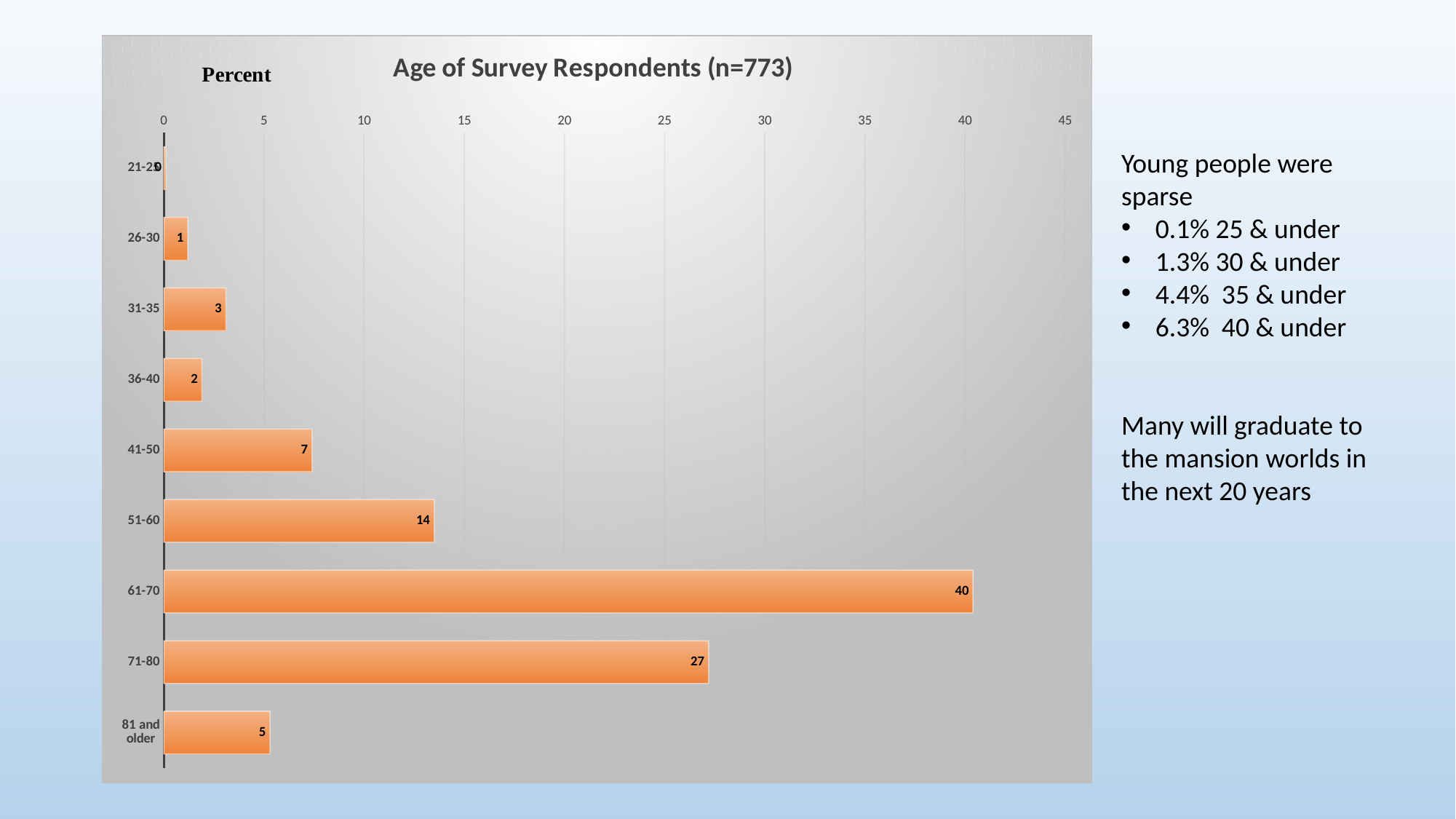
What is the difference between the values for the 61-70 and 71-80 age groups? 13 How many age groups are shown in the chart? 9 Is the value for the 71-80 age group greater or less than 25? greater What is the value for the 81 and older age group? 5 What is the title of the chart? Age of Survey Respondents (n=773) What is the difference between the values for the 51-60 and 41-50 age groups? 7 Which age group has the highest value? 61-70 What is the value for the 51-60 age group? 14 What is the value for the 41-50 age group? 7 What type of chart is shown on the slide? bar chart Which has a larger value, the 31-35 age group or the 36-40 age group? 31-35 What is the value for the 61-70 age group? 40